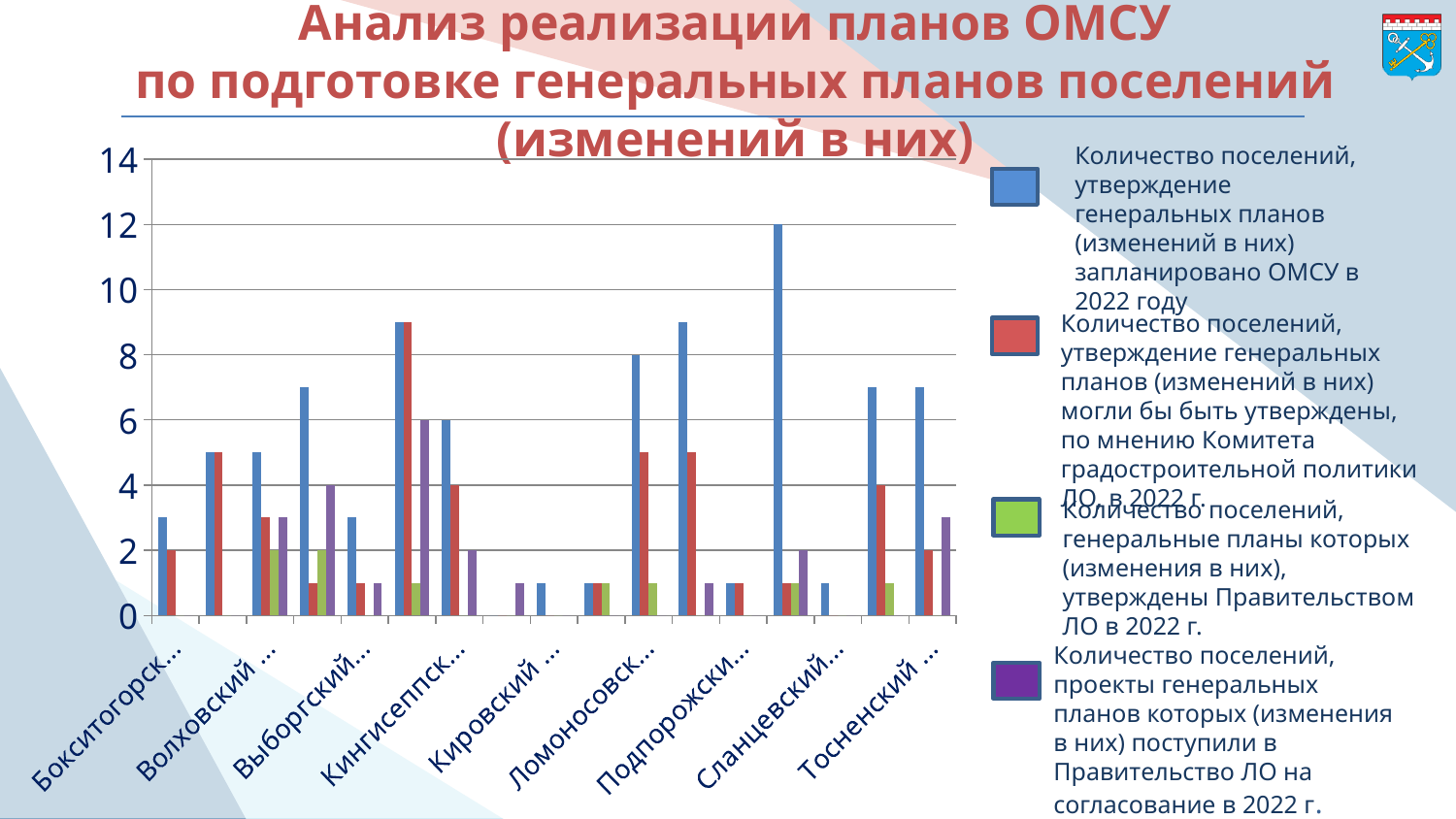
Is the value of the blue series for Тосненский... greater or less than 6? greater What is the value of the red series for Бокситогорск...? 2 How many series does the legend list? 4 What is the value of the red series (could have been approved, per the Committee) for Кингисеппск...? 4 Is the value of the red series for Ломоносовск... greater or less than 4? greater For Ломоносовск..., which is larger: the blue series or the red series? the blue series Which series contains the tallest bar on the chart? the blue series (planned by OMSU in 2022) What colour represents the series of settlements whose general plans were approved by the Government of LO in 2022? green What is the value of the blue series (planned by OMSU in 2022) for Кингисеппск...? 6 Is the value of the blue series for Кировский... greater or less than 2? less What is the value of the blue series (planned by OMSU in 2022) for Ломоносовск...? 8 What kind of chart is shown on the slide? bar chart